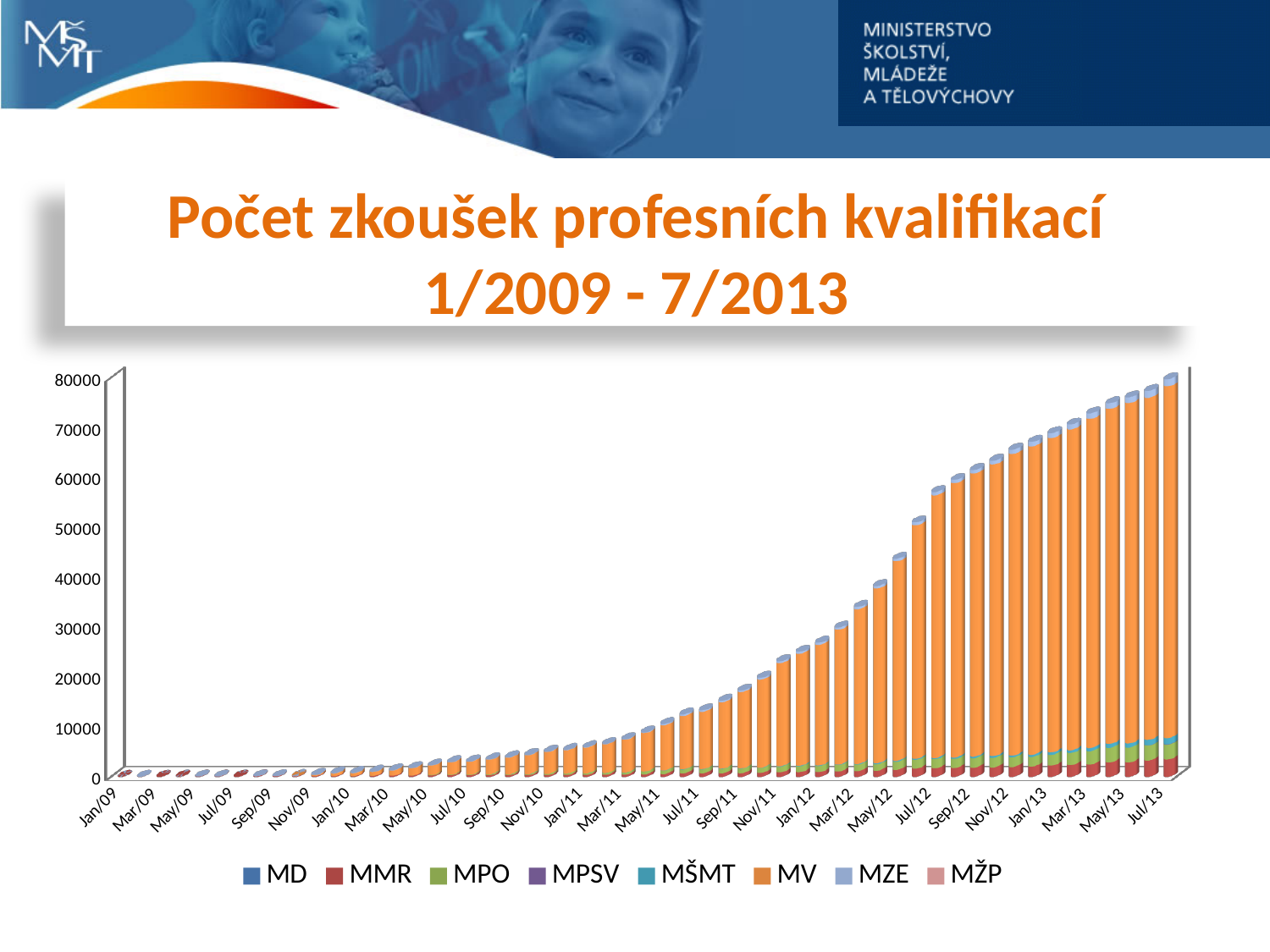
Is the total for Jul/13 greater or less than 70000? greater Which is larger, the total for Jul/13 or the total for Jan/12? Jul/13 Which month has the highest total number of exams? Jul/13 What kind of chart is shown on the slide? stacked bar chart How many series does the legend list? 8 Which month has the lowest total number of exams? Jan/09 What is the title of the chart? Počet zkoušek profesních kvalifikací 1/2009 - 7/2013 Is the total for Jul/11 greater or less than 20000? less Is the total for Jan/11 greater or less than 10000? less Do the totals rise or fall from Jan/09 to Jul/13? rise